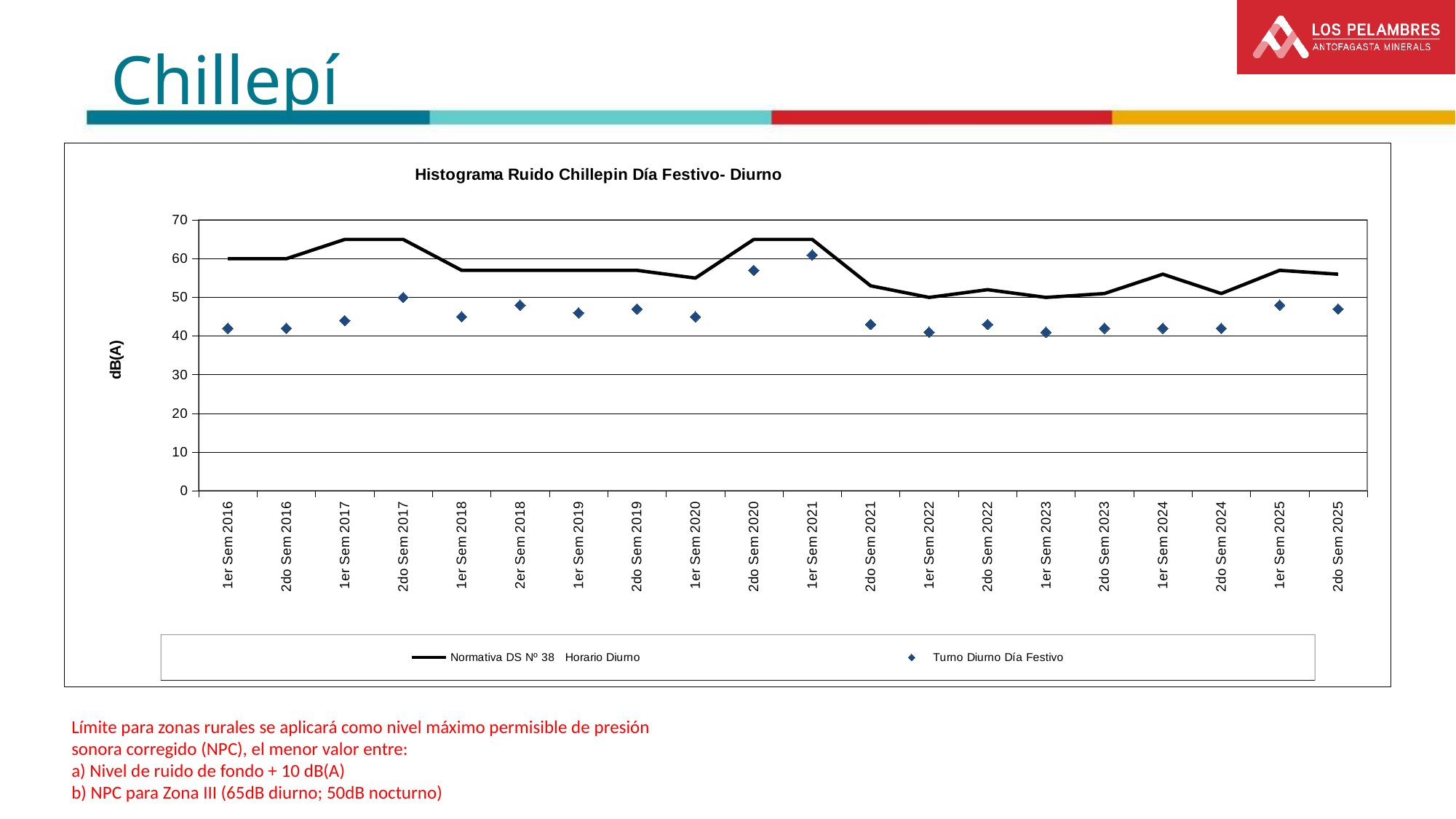
What is the value of the Normativa DS Nº 38 Horario Diurno line at 1er Sem 2023? 50 What is the value of Turno Diurno Día Festivo at 2do Sem 2017? 50 How many series does the legend list? 2 How many periods are shown along the x axis? 20 Is the Turno Diurno Día Festivo value for 1er Sem 2016 greater or less than 50? less Is the Turno Diurno Día Festivo value for 1er Sem 2021 greater or less than 50? greater What kind of chart is shown on the slide? line chart In which period is the Turno Diurno Día Festivo value highest? 1er Sem 2021 What is the label on the vertical axis? dB(A) What is the title of the chart? Histograma Ruido Chillepin Día Festivo- Diurno At 2do Sem 2020, which is higher: the Normativa DS Nº 38 Horario Diurno line or the Turno Diurno Día Festivo point? Normativa DS Nº 38 Horario Diurno What is the value of the Normativa DS Nº 38 Horario Diurno line at 1er Sem 2016? 60